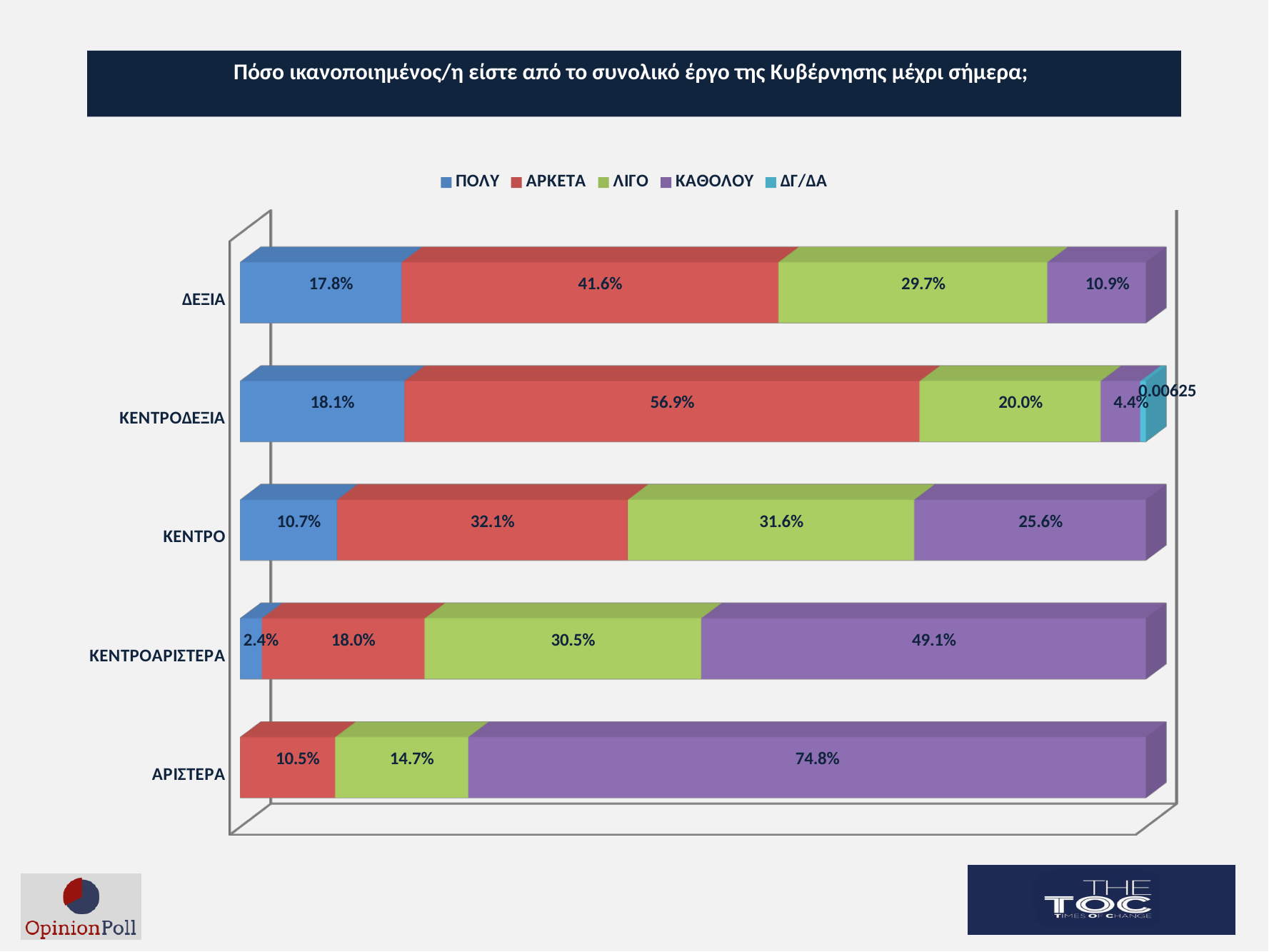
What is the ΛΙΓΟ value for ΚΕΝΤΡΟ? 31.6% Which category has the highest ΚΑΘΟΛΟΥ value? ΑΡΙΣΤΕΡΑ What kind of chart is shown on the slide? Stacked bar chart Which category has the lowest ΠΟΛΥ value among those with a ΠΟΛΥ segment? ΚΕΝΤΡΟΑΡΙΣΤΕΡΑ Which is larger: the ΛΙΓΟ value for ΔΕΞΙΑ or the ΛΙΓΟ value for ΚΕΝΤΡΟΔΕΞΙΑ? ΔΕΞΙΑ How many series does the legend list? 5 What is the difference between the ΑΡΚΕΤΑ values for ΚΕΝΤΡΟΔΕΞΙΑ and ΔΕΞΙΑ? 15.3% What is the ΚΑΘΟΛΟΥ value for ΑΡΙΣΤΕΡΑ? 74.8% What is the ΠΟΛΥ value for ΚΕΝΤΡΟΑΡΙΣΤΕΡΑ? 2.4% How many categories are shown on the chart? 5 Which category is the only one with a ΔΓ/ΔΑ segment labelled? ΚΕΝΤΡΟΔΕΞΙΑ What is the ΑΡΚΕΤΑ value for ΚΕΝΤΡΟΔΕΞΙΑ? 56.9%